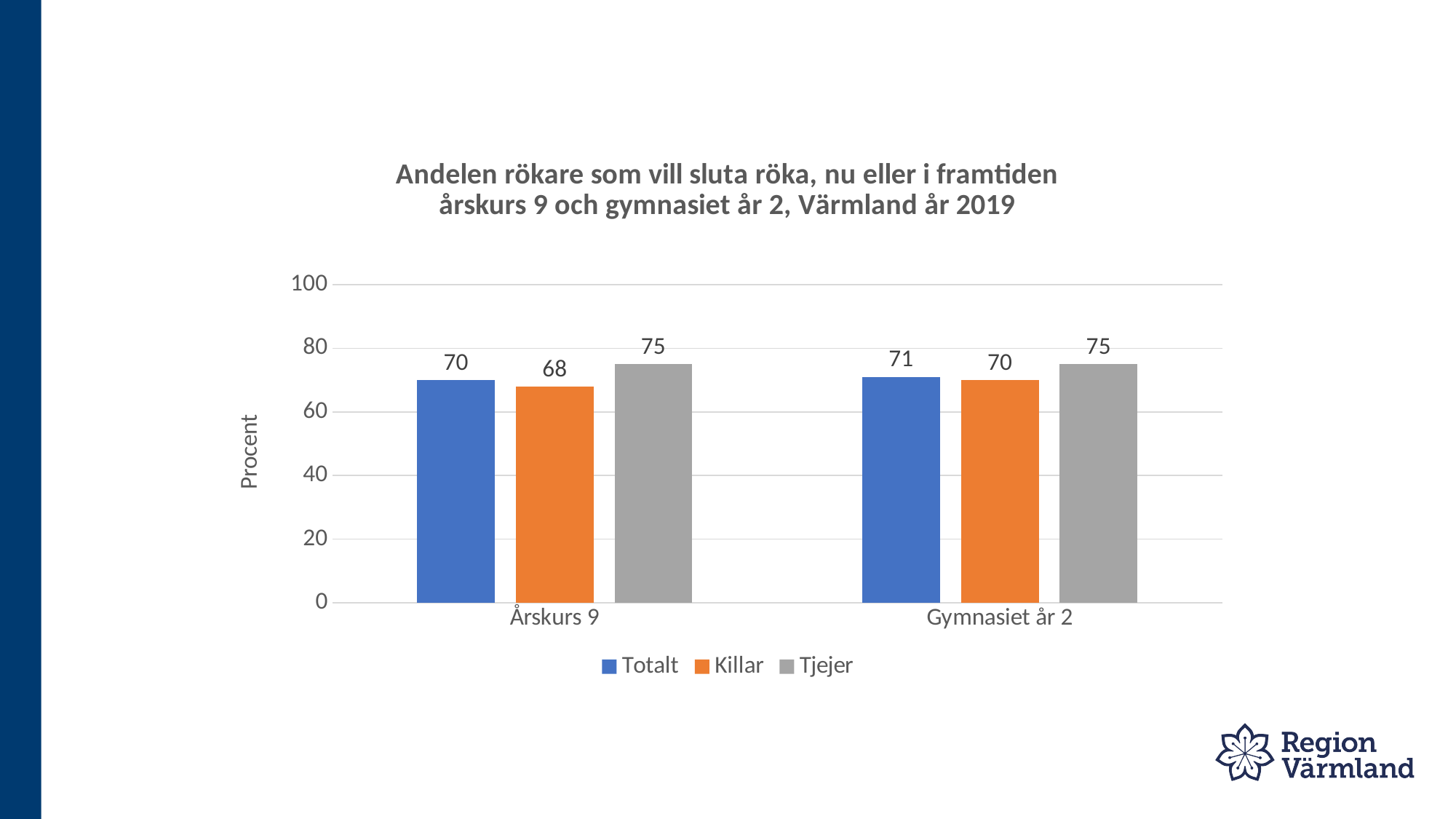
What is the value for Totalt in Årskurs 9? 70 What is the difference between Tjejer and Totalt in Gymnasiet år 2? 4 What is the value for Tjejer in Årskurs 9? 75 How many series does the legend list? 3 Which is larger: Killar in Årskurs 9 or Killar in Gymnasiet år 2? Killar in Gymnasiet år 2 What is the value for Totalt in Gymnasiet år 2? 71 Which series has the highest value in Gymnasiet år 2? Tjejer What is the difference between Tjejer and Killar in Årskurs 9? 7 Which series has the lowest value in Årskurs 9? Killar What kind of chart is shown on the slide? Bar chart How many categories are shown on the x axis? 2 What is the value for Killar in Gymnasiet år 2? 70